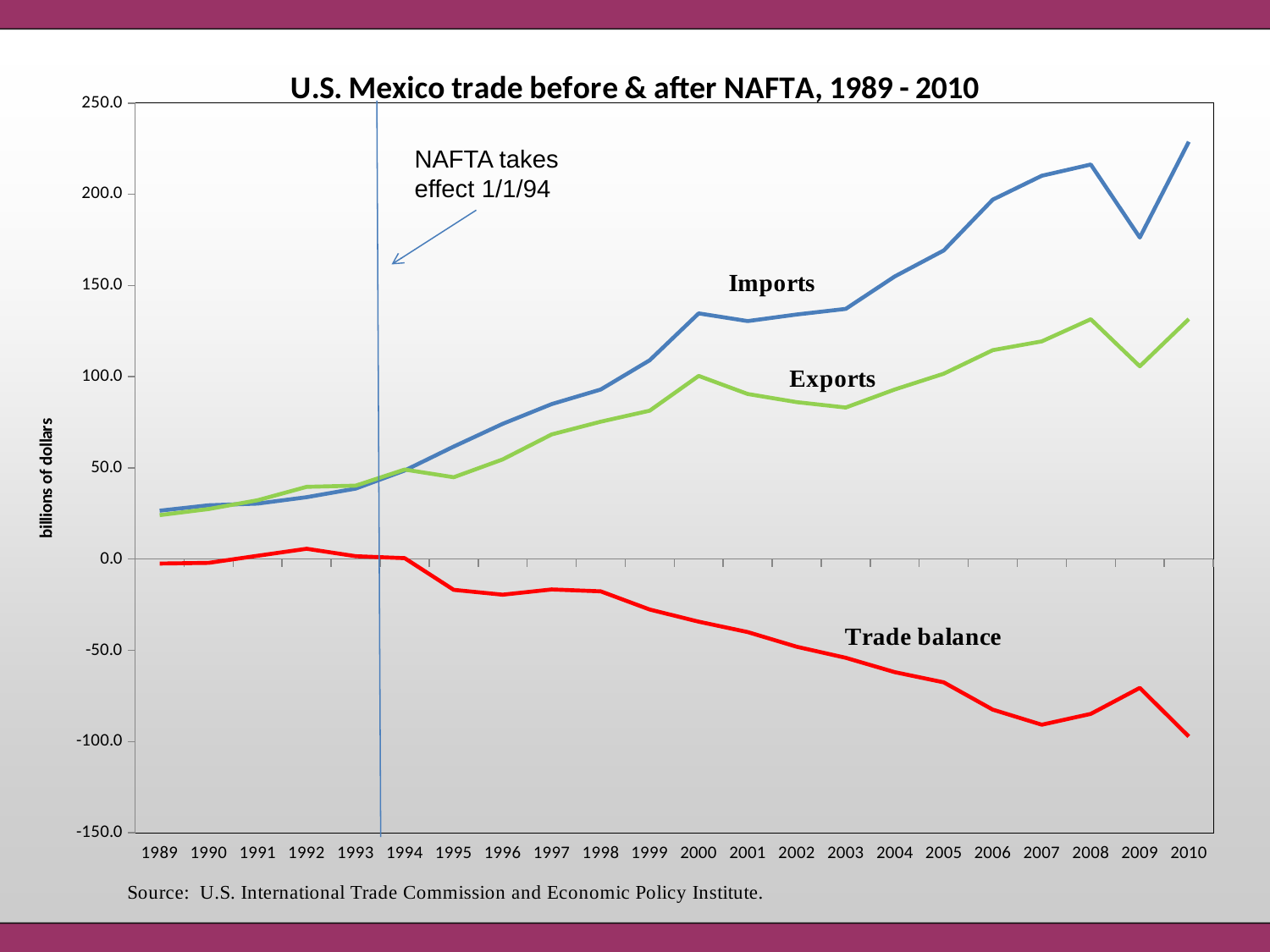
What kind of chart is shown on the slide? line chart Is the Imports value for 2010 greater or less than 200.0? greater In which year is the Imports value highest? 2010 What is the title of the chart? U.S. Mexico trade before & after NAFTA, 1989 - 2010 Does the Trade balance generally rise or fall from 1994 to 2010? fall Which is larger in 2005, Imports or Exports? Imports How many series are plotted on the chart? 3 Is the Trade balance value for 2010 greater or less than -50.0? less What is the label on the vertical axis? billions of dollars How many years are shown along the x axis? 22 Is the Imports value for 2009 greater or less than 150.0? greater In which year is the Imports value lowest? 1989